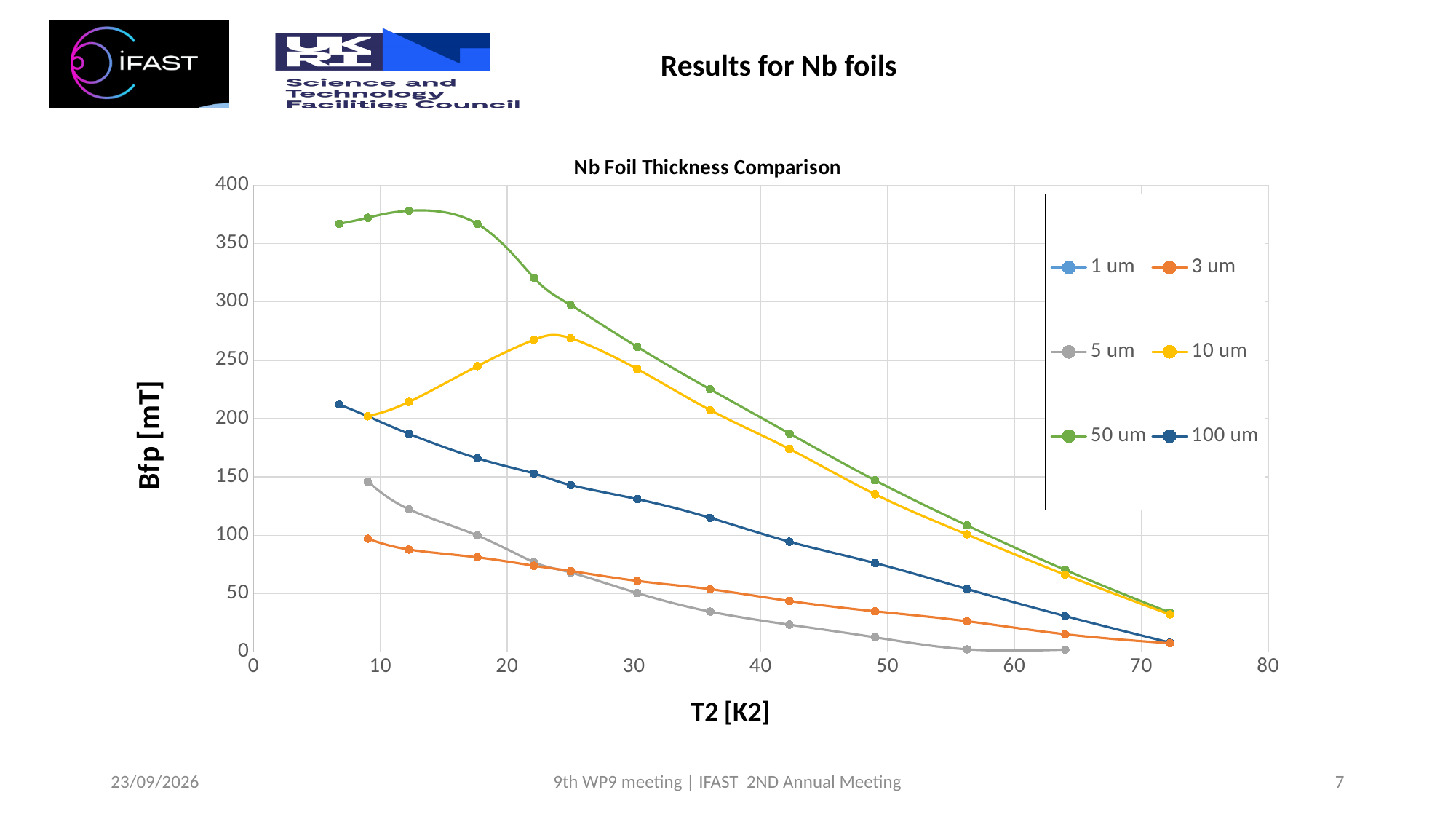
What is the title of the chart? Nb Foil Thickness Comparison Does the Bfp value for the 3 um series rise or fall as T2 increases? fall At T2 of about 30, which series has the larger Bfp value, 50 um or 10 um? 50 um Which series reaches the highest Bfp value on the chart? 50 um Is the peak Bfp value of the 10 um series greater or less than 250? greater At T2 of about 22, which series has the larger Bfp value, 100 um or 5 um? 100 um What kind of chart is shown on the slide? line chart Is the first plotted Bfp value of the 100 um series (at T2 of about 7) greater or less than 200? greater Does the Bfp value for the 100 um series rise or fall as T2 increases? fall How many series does the chart legend list? 6 What is the label of the vertical axis? Bfp [mT]